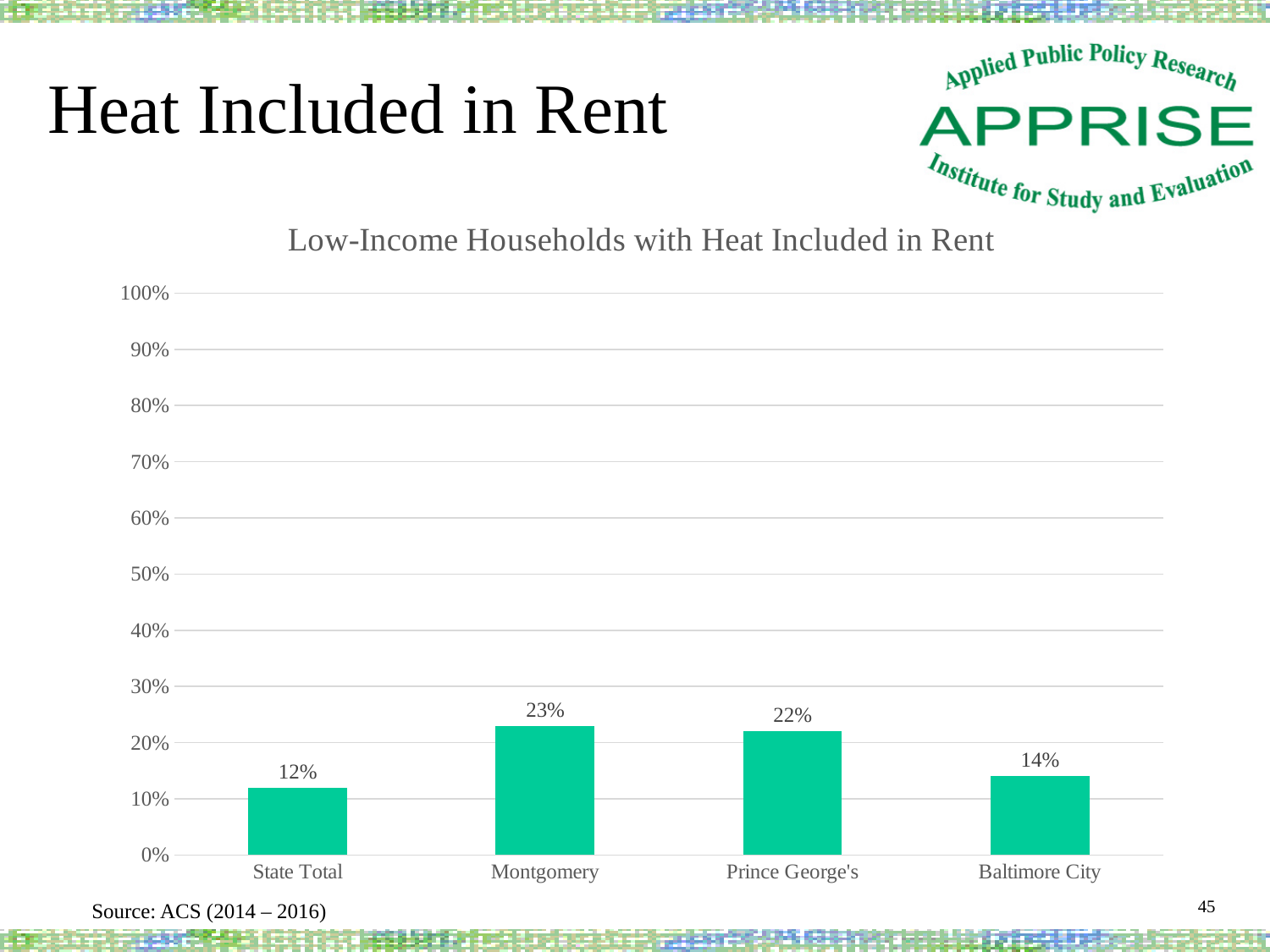
Is the value for Prince George's greater or less than 30%? less What kind of chart is shown on the slide? bar chart What is the value for Montgomery? 23% What is the value for Baltimore City? 14% What is the value for Prince George's? 22% What is the value for State Total? 12% Which category has the lowest value? State Total Which is larger, the value for Baltimore City or the value for Prince George's? Prince George's Which category has the highest value? Montgomery How many categories are shown on the x axis? 4 What is the title of the chart? Low-Income Households with Heat Included in Rent What is the difference between the values for Montgomery and State Total? 11%